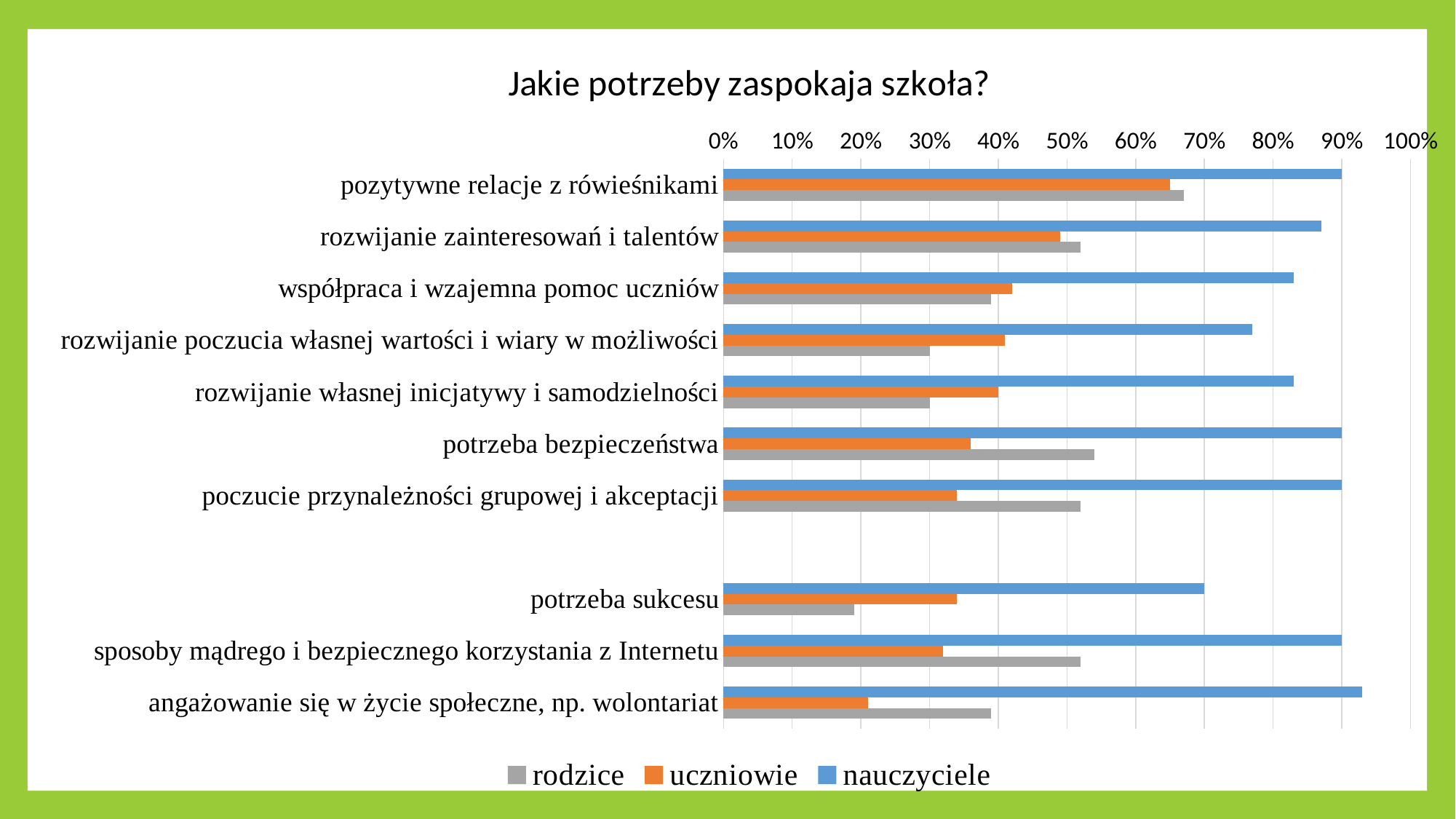
What kind of chart is shown on the slide? bar chart Is the rodzice value for 'potrzeba sukcesu' greater or less than 30%? less What is the title of the chart? Jakie potrzeby zaspokaja szkoła? For 'potrzeba bezpieczeństwa', which is larger: the rodzice value or the uczniowie value? rodzice Is the uczniowie value for 'pozytywne relacje z rówieśnikami' greater or less than 60%? greater Which series is shown in blue? nauczyciele Is the nauczyciele value for 'rozwijanie poczucia własnej wartości i wiary w możliwości' greater or less than 80%? less For which category is the rodzice value highest? pozytywne relacje z rówieśnikami How many series does the legend list? 3 For which category is the nauczyciele value lowest? potrzeba sukcesu